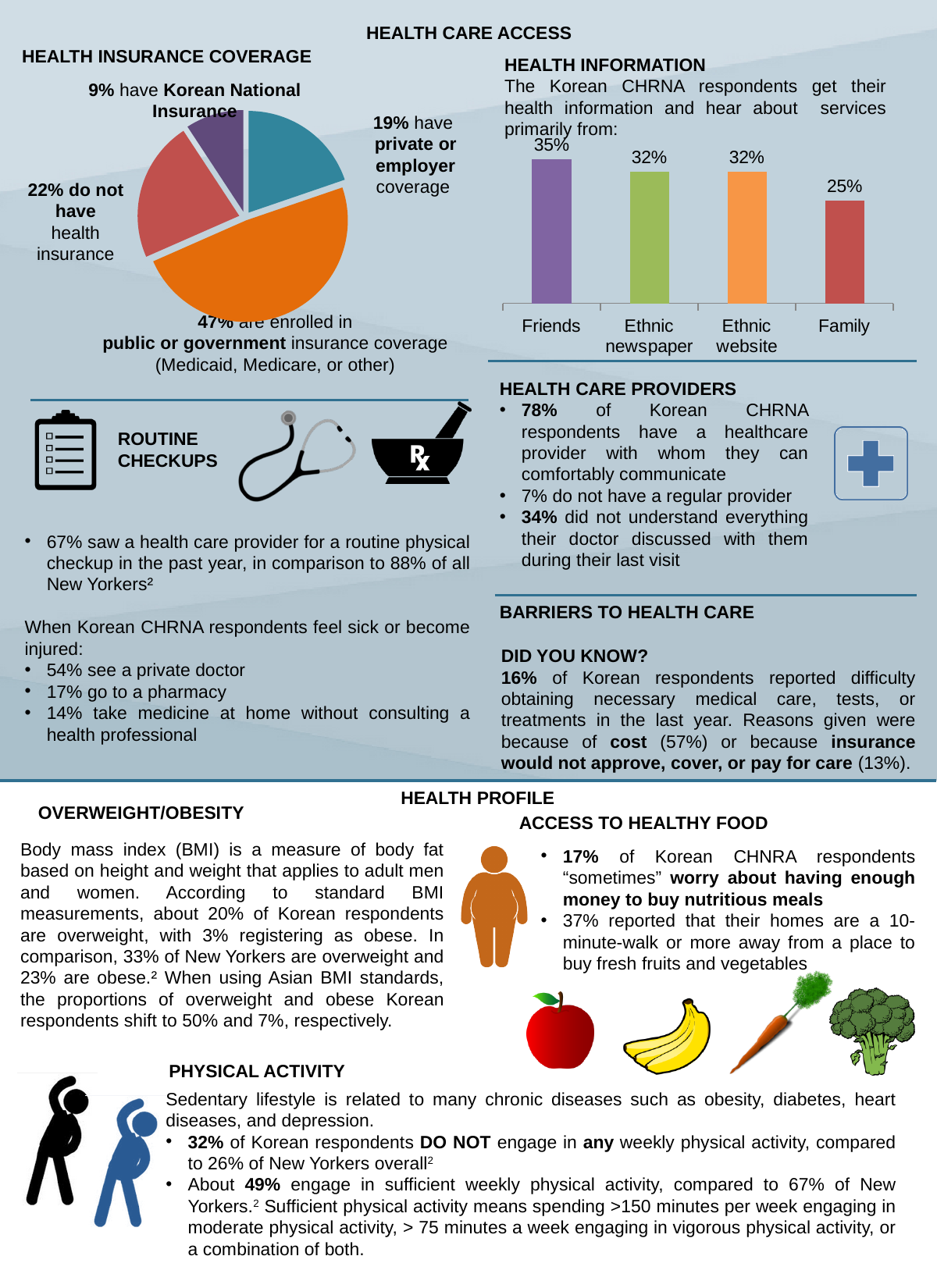
What type of chart is used in the Health Information section? Bar chart In the Health Information bar chart, what percentage of respondents get their health information from friends? 35% In the Health Information bar chart, what is the difference between the values for Friends and Family? 10 percentage points In the Health Insurance Coverage pie chart, which is larger: the share with private or employer coverage or the share without health insurance? The share without health insurance How many categories are shown in the Health Information bar chart? 4 In the Health Insurance Coverage pie chart, what share of respondents do not have health insurance? 22% In the Health Insurance Coverage pie chart, what share of respondents are enrolled in public or government insurance coverage? 47% In the Health Insurance Coverage pie chart, which category is the smallest slice? Korean National Insurance In the Health Insurance Coverage pie chart, which category is the largest slice? Public or government insurance coverage In the Health Information bar chart, which source has the highest value? Friends In the Health Information bar chart, which source has the lowest value? Family In the Health Information bar chart, what is the value for Family? 25%